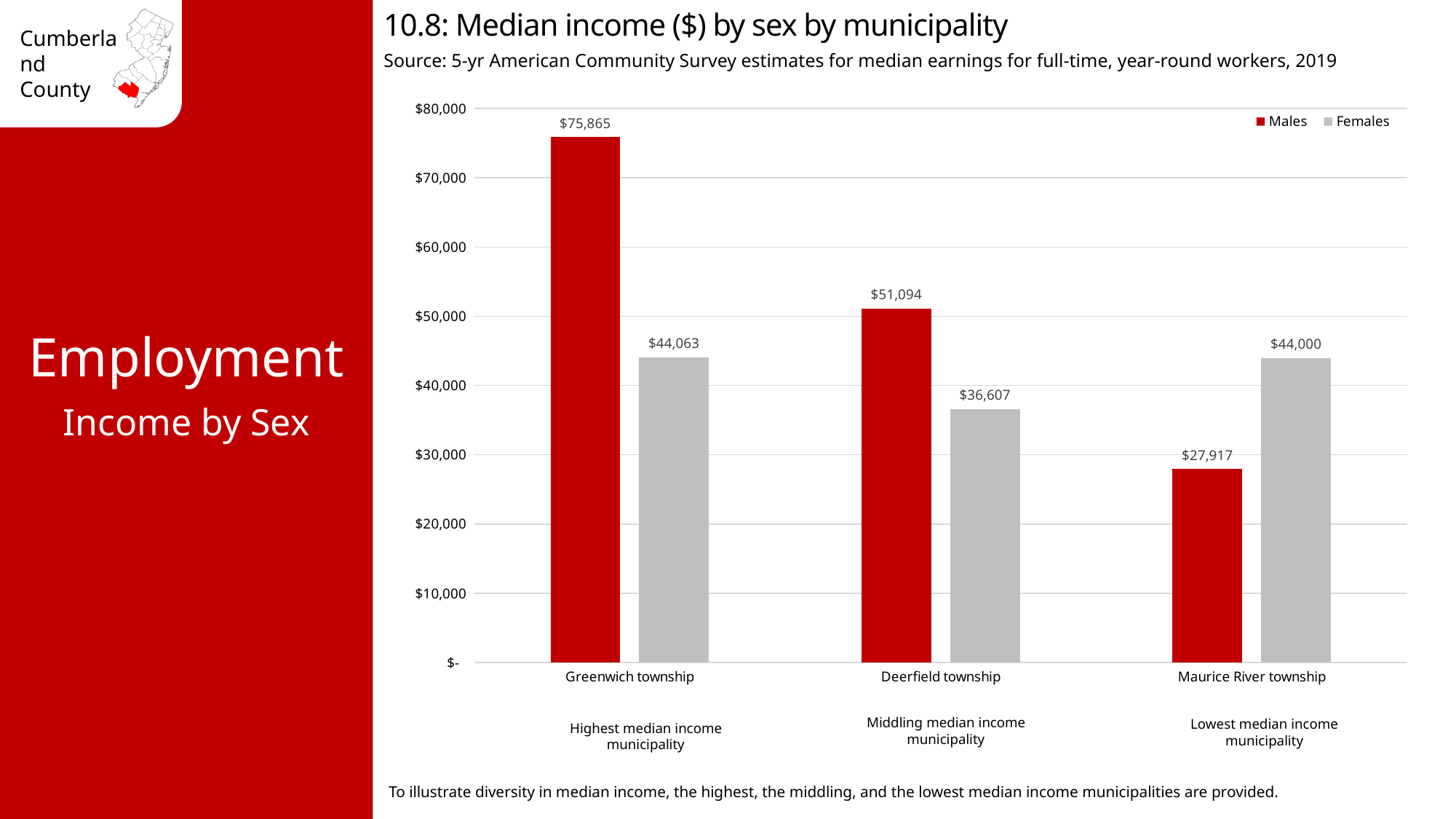
How many series does the legend list? 2 In Maurice River township, which is larger: the median income for males or for females? Females What is the median income for females in Deerfield township? $36,607 Is the median income for males in Deerfield township greater or less than $50,000? greater Which municipality has the highest median income for males? Greenwich township What is the median income for females in Maurice River township? $44,000 What is the difference between male and female median income in Greenwich township? $31,802 Which municipality has the lowest median income for females? Deerfield township What is the median income for males in Maurice River township? $27,917 What is the median income for males in Greenwich township? $75,865 What kind of chart is shown on the slide? Bar chart How many municipalities are shown on the chart? 3